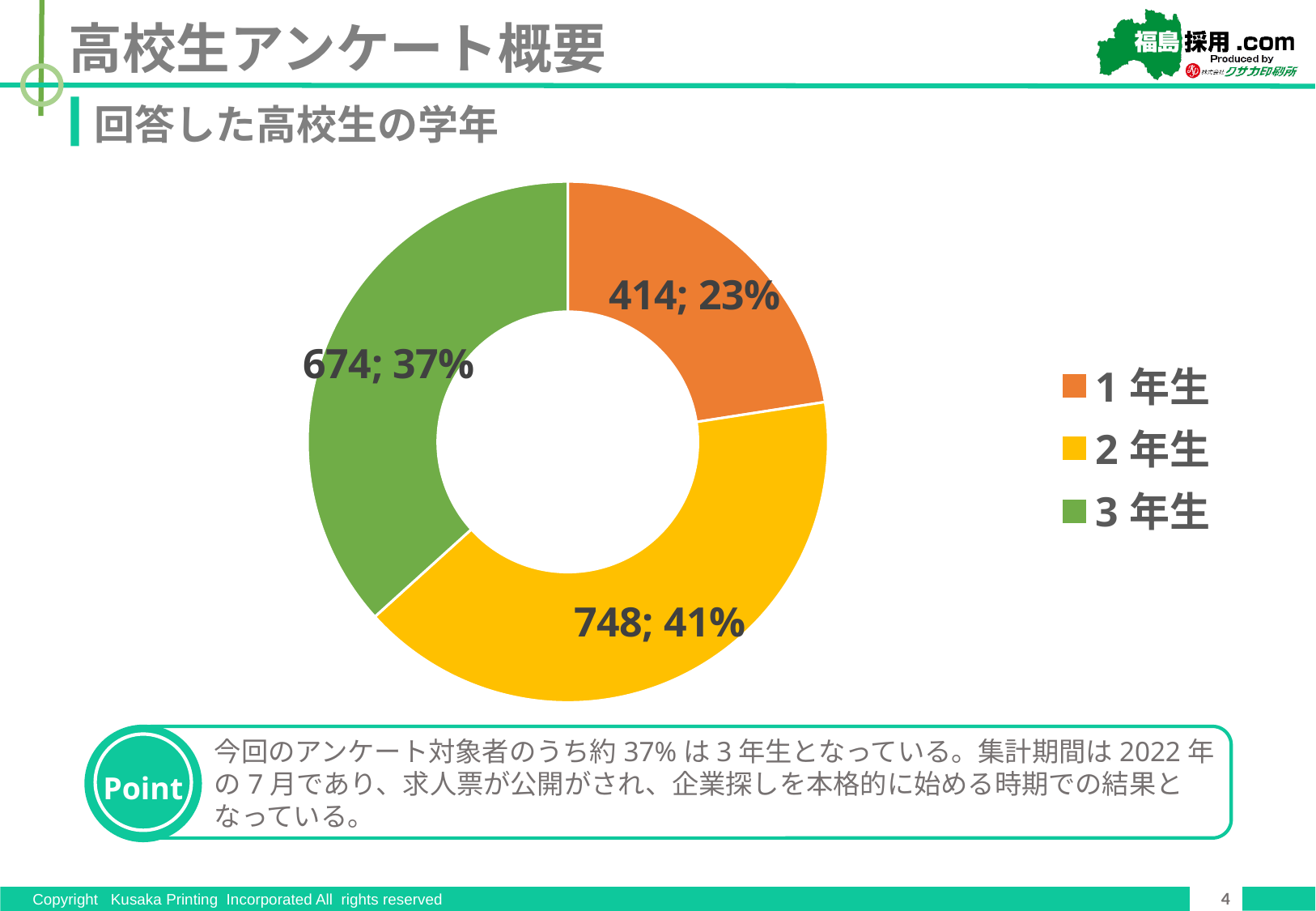
What share of respondents were 3年生? 37% What colour represents 2年生 in the chart? Yellow How many respondents were 1年生 (first-year students)? 414 What is the difference between the number of 2年生 and 3年生 respondents? 74 How many respondents were 2年生 (second-year students)? 748 Which has more respondents, 1年生 or 3年生? 3年生 What share of respondents were 1年生? 23% Which grade has the smallest number of respondents? 1年生 What kind of chart is shown on the slide? Doughnut (pie) chart How many respondents were 3年生 (third-year students)? 674 How many categories does the chart show? 3 Which grade has the largest number of respondents? 2年生